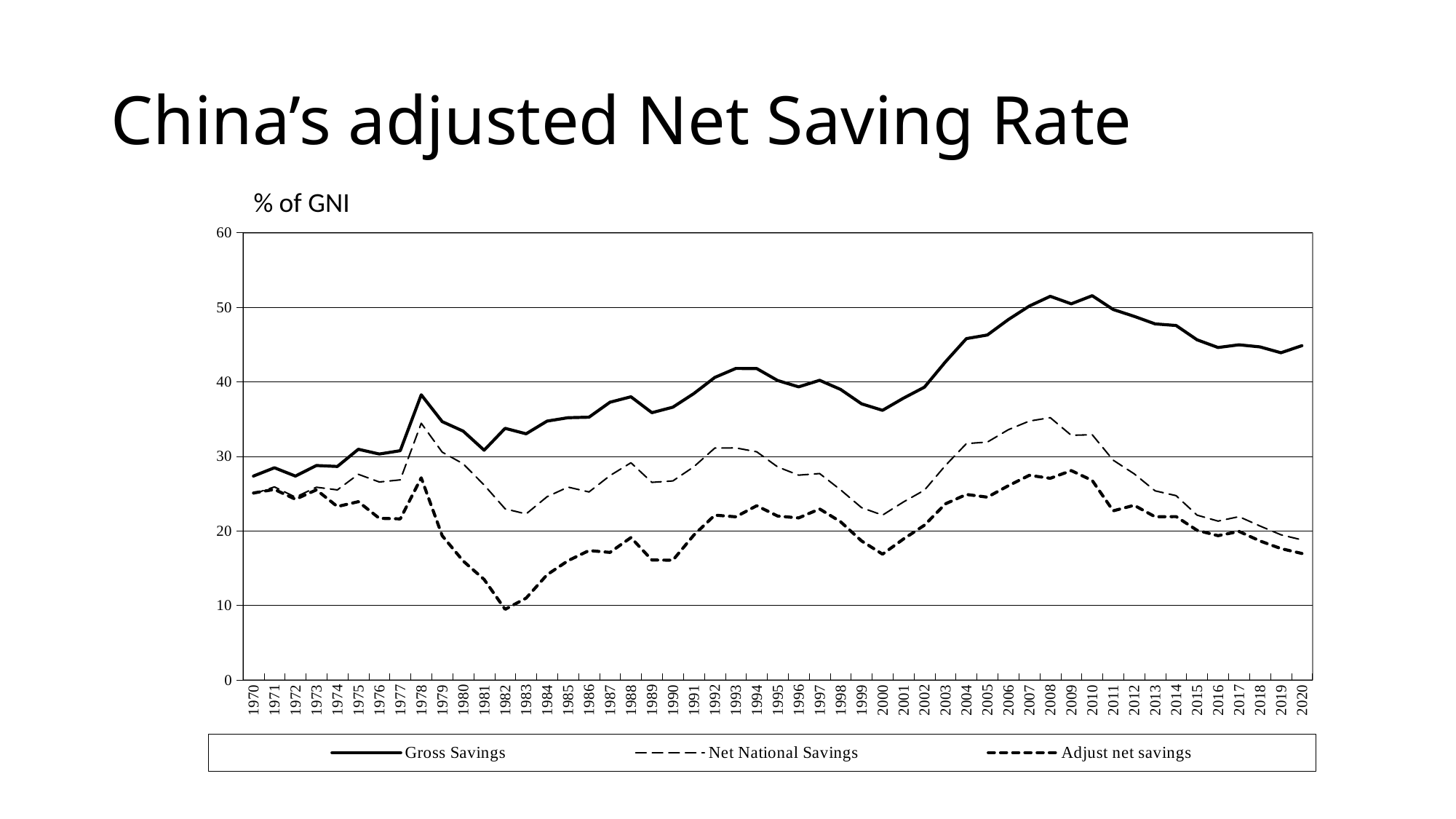
In 2008, which is larger: Gross Savings or Adjust net savings? Gross Savings Is the value for Net National Savings in 2008 greater or less than 30? greater Does the Gross Savings series rise or fall between 2010 and 2019? fall What kind of chart is shown on the slide? line chart What unit label is shown above the chart's y axis? % of GNI How many years are plotted along the x axis? 51 What is the title of the slide? China's adjusted Net Saving Rate Is the value for Adjust net savings in 2020 greater or less than 20? less In which year is the Adjust net savings series at its lowest? 1982 How many series does the legend list? 3 Is the value for Gross Savings in 1970 greater or less than 30? less